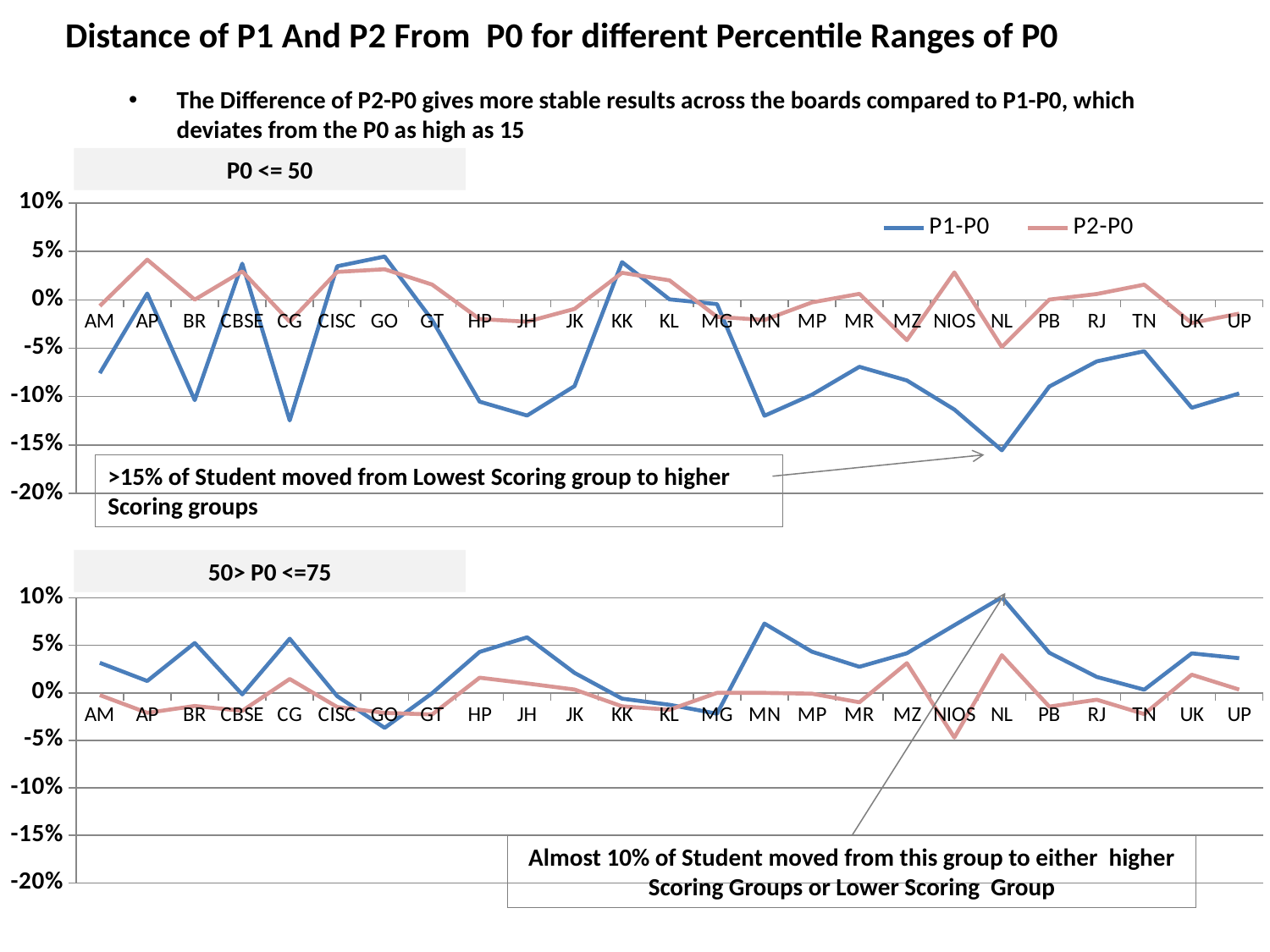
How many series does the legend of the 'P0 <= 50' chart list? 2 In the 'P0 <= 50' chart, which board has the lowest P1-P0 value? NL What are the two series names shown in the legend of the top chart? P1-P0 and P2-P0 What kind of chart is the 'P0 <= 50' chart? line chart In the '50> P0 <=75' chart, which board has the highest P1-P0 value? NL In the '50> P0 <=75' chart, is the P1-P0 value for MN greater or less than 5%? greater In the '50> P0 <=75' chart, which series has the larger value at MN, P1-P0 or P2-P0? P1-P0 In the '50> P0 <=75' chart, which board has the lowest P2-P0 value? NIOS In the '50> P0 <=75' chart, which board has the lowest P1-P0 value? GO In the 'P0 <= 50' chart, is the P1-P0 value for CG greater or less than -10%? less How many boards (categories) are plotted along the x axis of the '50> P0 <=75' chart? 25 In the 'P0 <= 50' chart, which series has the larger value at NL, P1-P0 or P2-P0? P2-P0